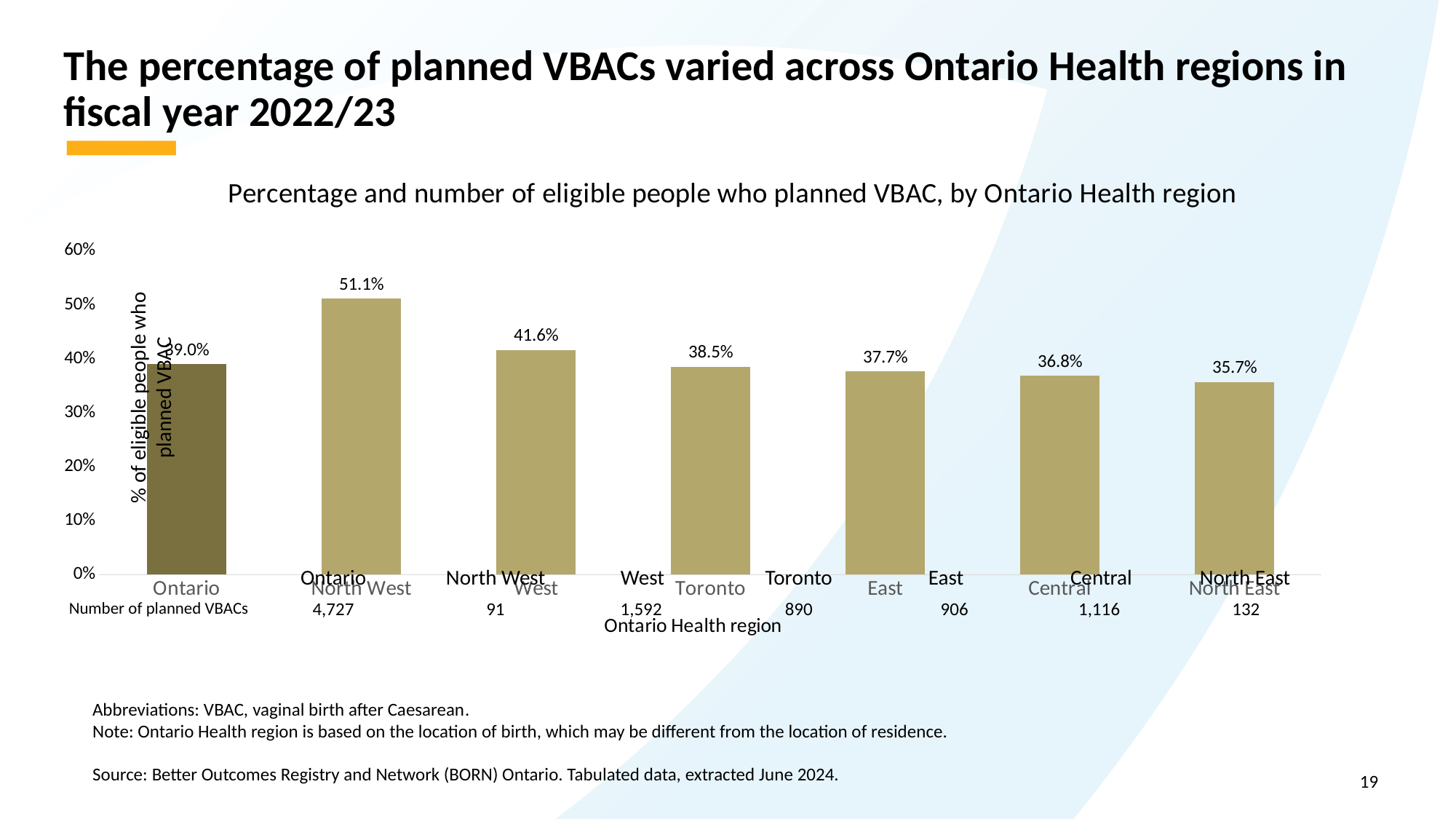
What percentage of eligible people planned VBAC in the Toronto region? 38.5% What percentage of eligible people planned VBAC in the North West region? 51.1% What is the difference in percentage points between the West and Central regions? 4.8 What kind of chart is shown on the slide? Bar chart Which Ontario Health region has the lowest percentage of planned VBACs? North East What percentage of eligible people planned VBAC in the North East region? 35.7% Is the value for the West region greater or less than 40%? greater What is the number of planned VBACs shown for the West region? 1,592 Which Ontario Health region has the highest percentage of planned VBACs? North West What is the label on the vertical axis of the chart? % of eligible people who planned VBAC Which region has a higher percentage of planned VBACs, East or Central? East How many bars are shown in the chart? 7